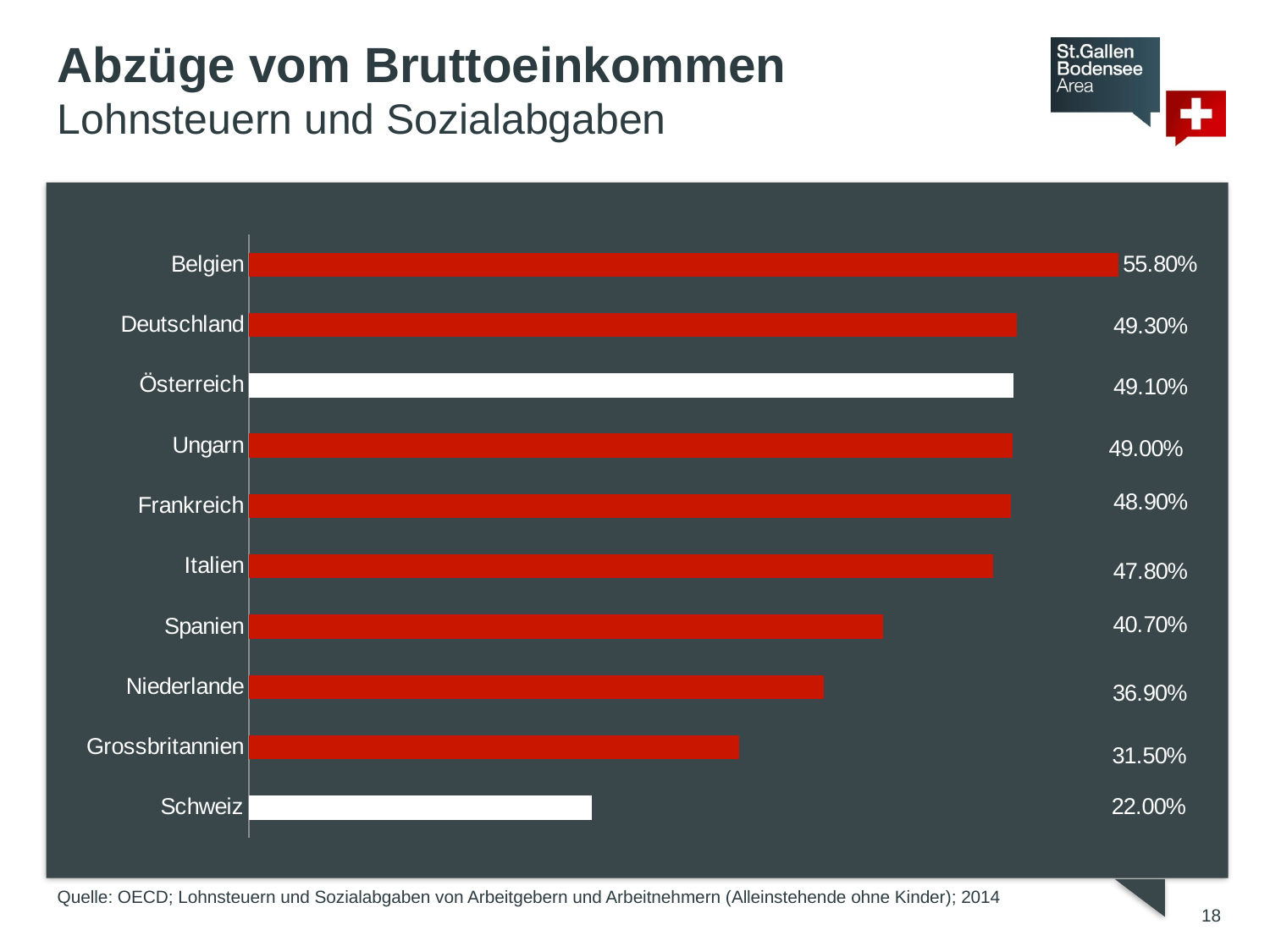
Which has a larger value, Spanien or Grossbritannien? Spanien What is the difference between the values for Deutschland and Österreich? 0.20% What is the value for Niederlande? 36.90% Which country has the lowest value? Schweiz Which has a larger value, Italien or Niederlande? Italien How many countries are shown in the chart? 10 Which country has the highest value? Belgien What is the value for Belgien? 55.80% What is the value for Schweiz? 22.00% What is the difference between the values for Belgien and Schweiz? 33.80% Which two countries have bars coloured white instead of red? Österreich and Schweiz What kind of chart is shown on the slide? Bar chart